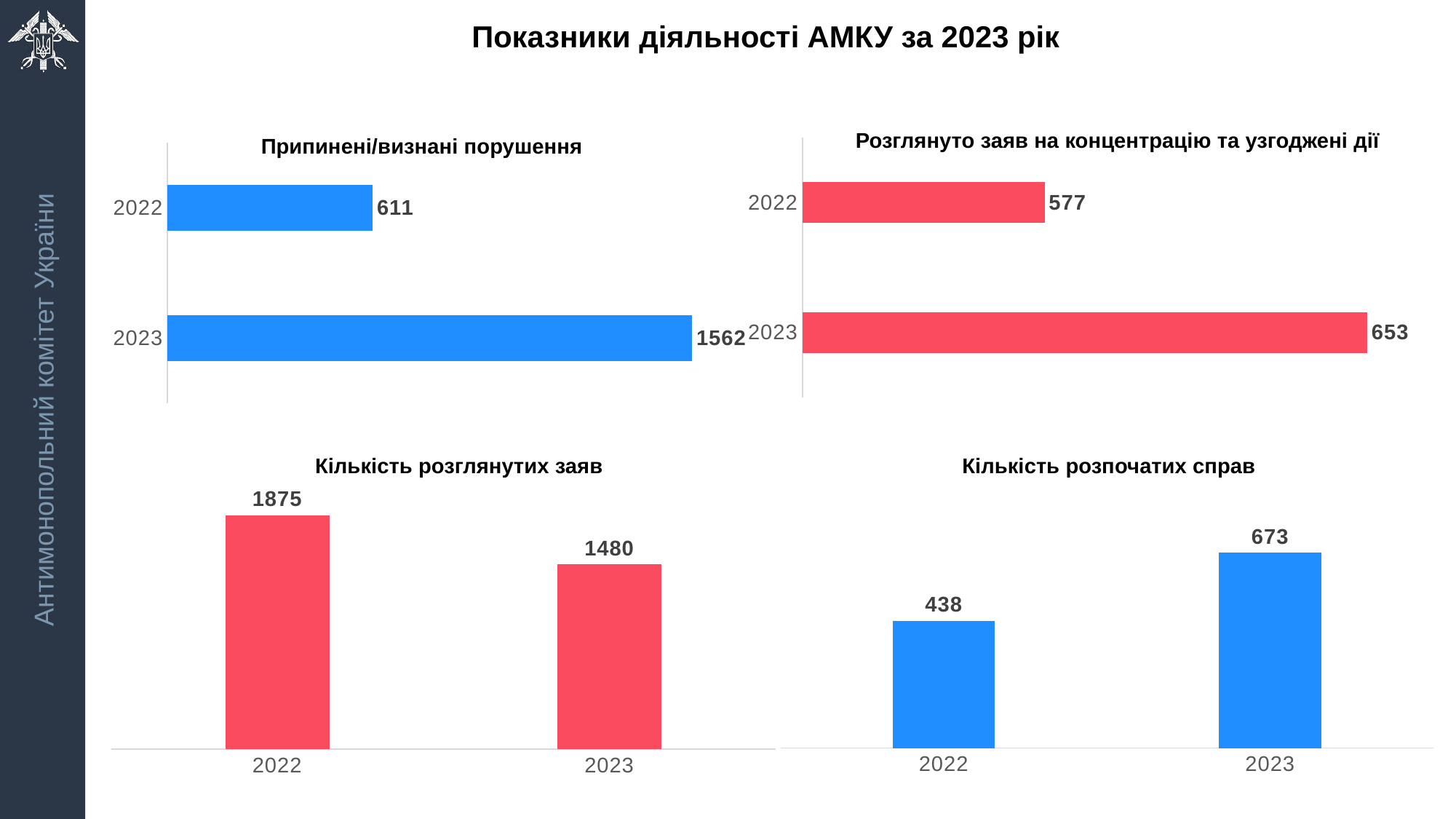
In the chart titled 'Припинені/визнані порушення', what is the value for 2022? 611 In the chart titled 'Розглянуто заяв на концентрацію та узгоджені дії', what is the value for 2022? 577 In the chart titled 'Кількість розпочатих справ', which year has the lower value? 2022 What kind of chart is the chart titled 'Кількість розпочатих справ'? bar chart In the chart titled 'Кількість розглянутих заяв', what is the value for 2022? 1875 In the chart titled 'Кількість розглянутих заяв', do the values rise or fall from 2022 to 2023? fall In the chart titled 'Припинені/визнані порушення', what is the value for 2023? 1562 In the chart titled 'Кількість розглянутих заяв', what is the difference between the 2022 and 2023 values? 395 In the chart titled 'Кількість розпочатих справ', what is the value for 2023? 673 In the chart titled 'Розглянуто заяв на концентрацію та узгоджені дії', which year has the higher value? 2023 In the chart titled 'Припинені/визнані порушення', what is the difference between the 2023 and 2022 values? 951 In the chart titled 'Розглянуто заяв на концентрацію та узгоджені дії', what is the difference between the 2023 and 2022 values? 76